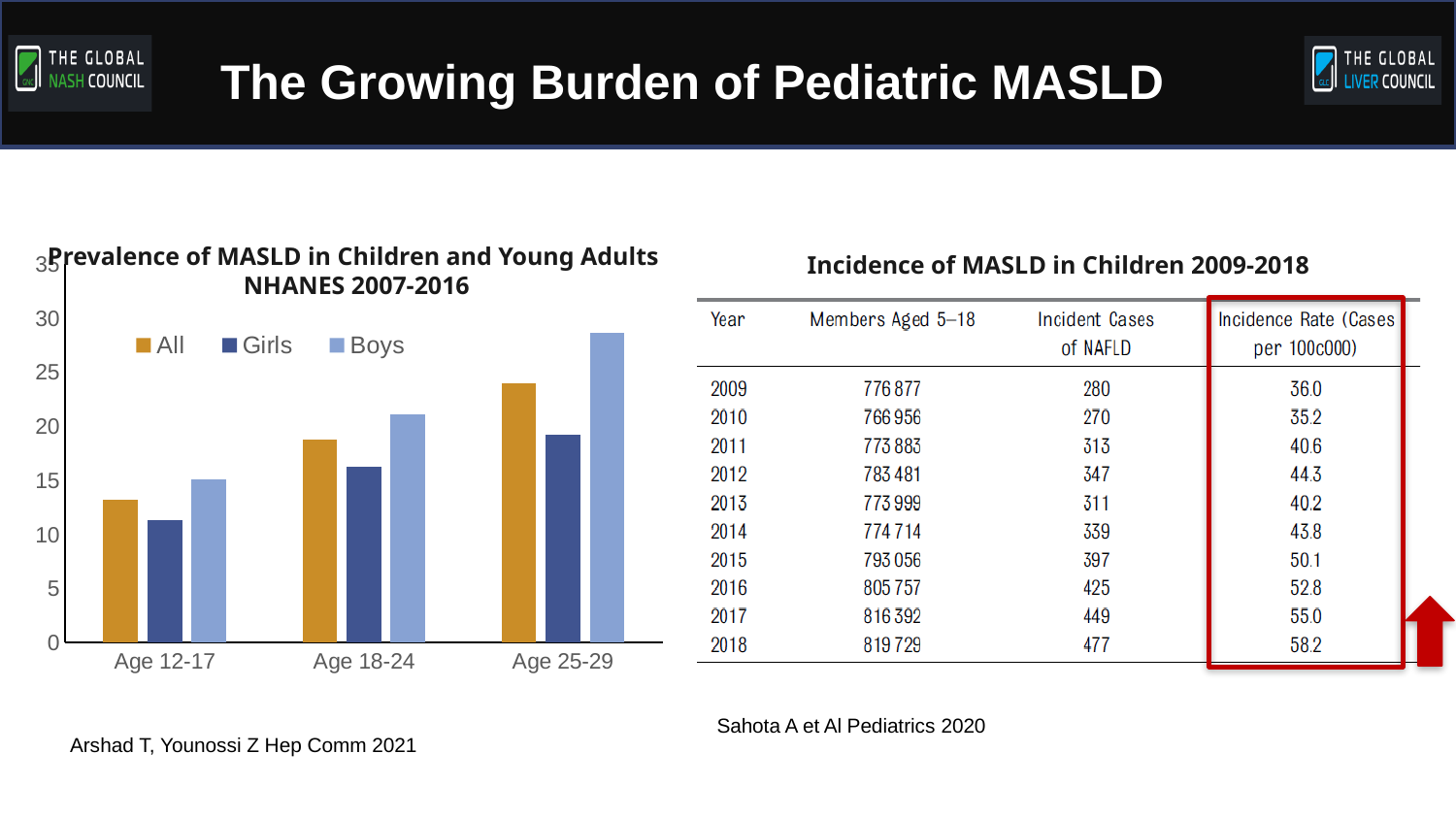
What kind of chart is the 'Prevalence of MASLD in Children and Young Adults NHANES 2007-2016' chart? Bar chart In the prevalence bar chart, for Age 25-29, which is larger: Boys or Girls? Boys In the prevalence bar chart, do the Boys values rise or fall from Age 12-17 to Age 25-29? Rise In the prevalence bar chart, is the value for All in Age 18-24 greater or less than 15? greater How many age groups are shown on the x axis of the prevalence bar chart? 3 In the prevalence bar chart, which age group has the highest value for All? Age 25-29 In the prevalence bar chart, is the value for Girls in Age 12-17 greater or less than 15? less In the prevalence bar chart, which age group has the lowest value for Girls? Age 12-17 What are the legend entries of the prevalence bar chart? All, Girls, Boys In the prevalence bar chart, is the value for Boys in Age 25-29 greater or less than 25? greater In the prevalence bar chart, which age group has the highest value for Boys? Age 25-29 How many series does the legend of the prevalence bar chart list? 3